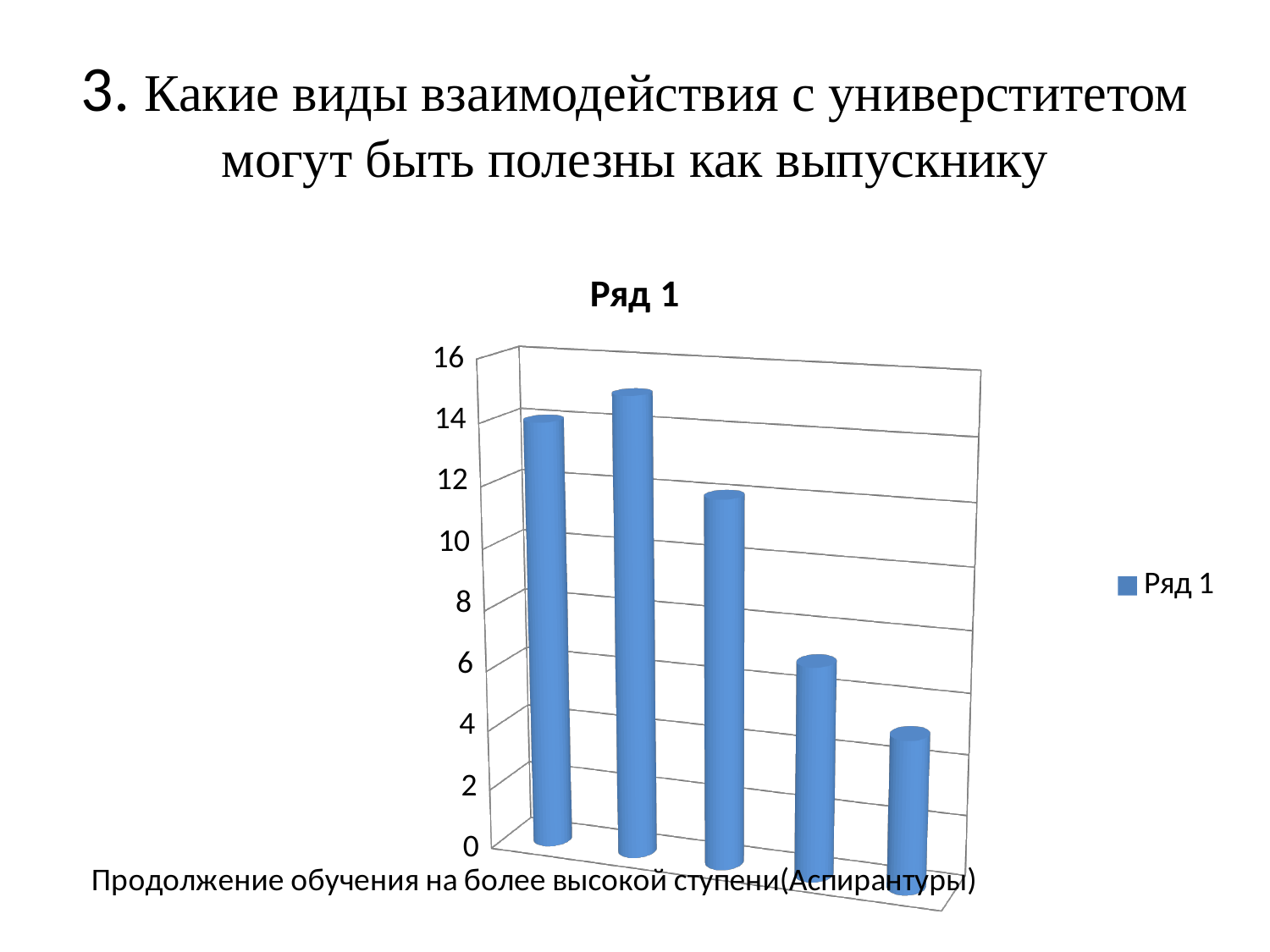
How many series does the legend list? 1 Which bar is the shortest in the chart? the fifth bar Do the values generally rise or fall from left to right across the chart? fall What is the title of the chart? Ряд 1 Which is larger, the first bar or the third bar? the first bar What is the name of the series shown in the legend? Ряд 1 Is the value of the fourth bar greater or less than 8? less Is the value of the fifth bar greater or less than 6? less Is the value of the first bar greater or less than 12? greater What kind of chart is shown on the slide? bar chart Which bar is the tallest in the chart? the second bar How many bars are plotted in the chart? 5